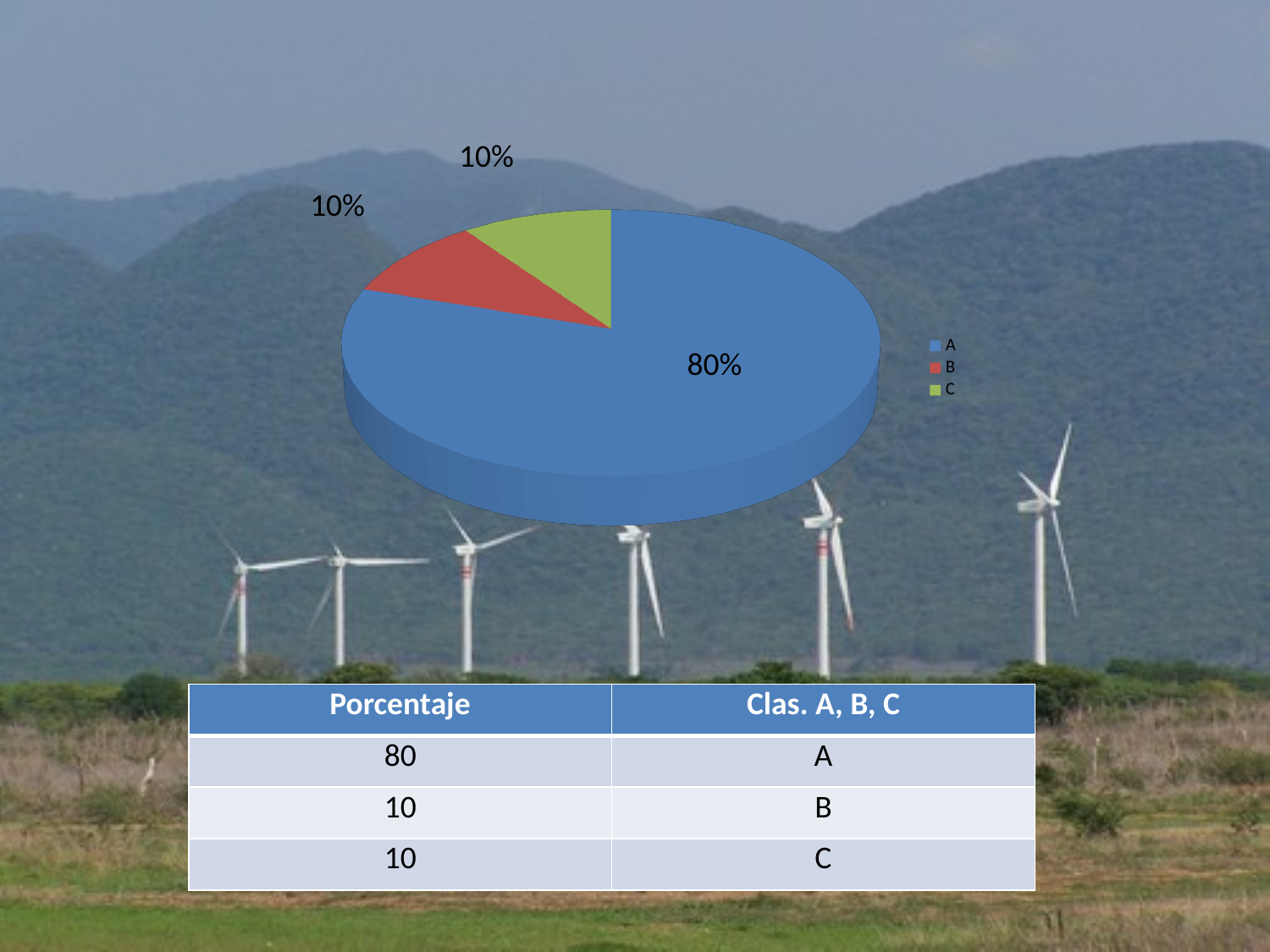
What is the difference in percentage points between slice A and slice B? 70 Which is larger in the pie chart, slice A or slice C? A How many slices does the pie chart have? 3 What percentage does slice B represent in the pie chart? 10% How many entries does the legend of the pie chart list? 3 What colour is slice C in the pie chart? green Which category has the largest slice in the pie chart? A What kind of chart is shown on the slide? pie chart What percentage does slice C represent in the pie chart? 10% Is the value for slice A greater or less than 50%? greater What colour is slice A in the pie chart? blue What percentage does slice A represent in the pie chart? 80%